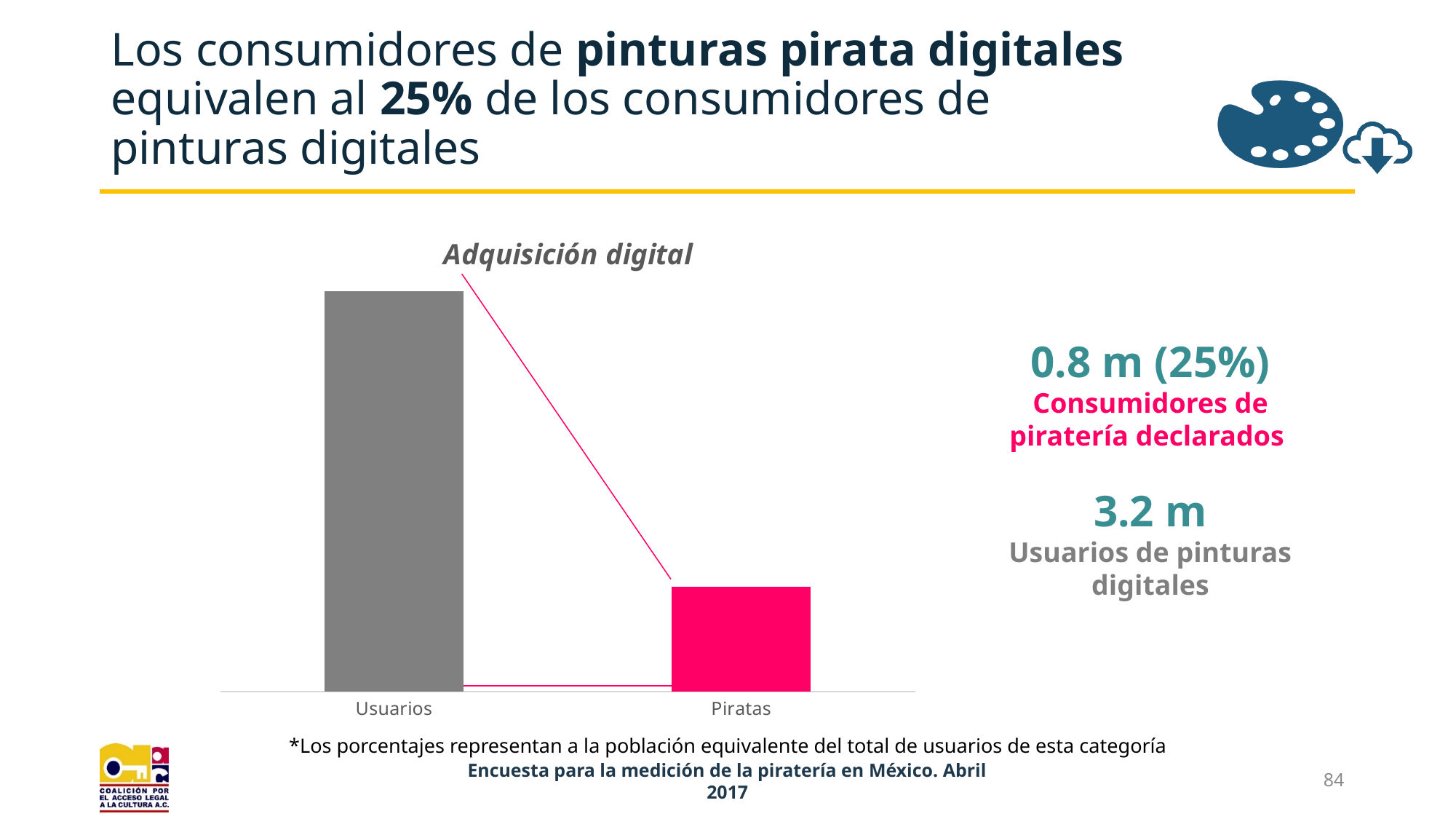
Do the bar values rise or fall from Usuarios to Piratas in the "Adquisición digital" chart? fall In the "Adquisición digital" chart, which bar is taller, Usuarios or Piratas? Usuarios According to the slide, how many declared piracy consumers (Consumidores de piratería declarados) are there? 0.8 m What is the difference between the number of Usuarios (3.2 m) and Piratas (0.8 m) shown on the slide? 2.4 m Which category has the tallest bar in the "Adquisición digital" chart? Usuarios What percentage of digital painting users do the declared piracy consumers represent, according to the slide? 25% According to the slide, how many users of digital paintings (Usuarios de pinturas digitales) are there? 3.2 m Which category has the shortest bar in the "Adquisición digital" chart? Piratas How many categories are shown on the x axis of the "Adquisición digital" chart? 2 What colour is the Piratas bar in the "Adquisición digital" chart? pink What kind of chart is shown under the title "Adquisición digital"? bar chart What is the title of the chart on the slide? Adquisición digital